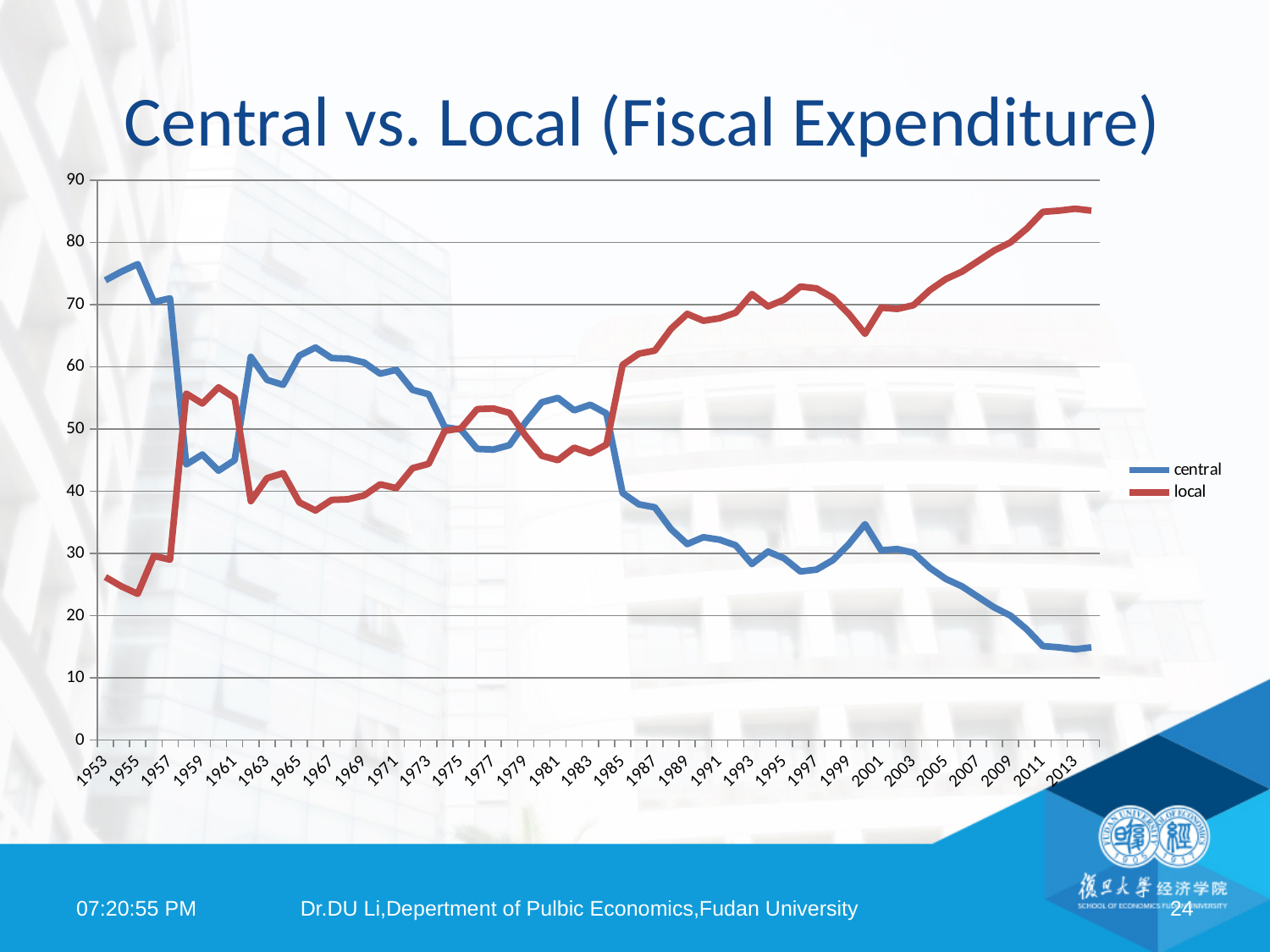
What kind of chart is shown on the slide? line chart How many series does the legend list? 2 What are the two series named in the legend? central and local Is the value for central in 1989 greater or less than 40? less Does the central series generally rise or fall from 1985 to 2013? fall Is the value for central in 2013 greater or less than 20? less What is the title of the chart? Central vs. Local (Fiscal Expenditure) Is the value for local in 2013 greater or less than 80? greater In 1953, which series has the larger value, central or local? central In 2011, which series has the larger value, central or local? local